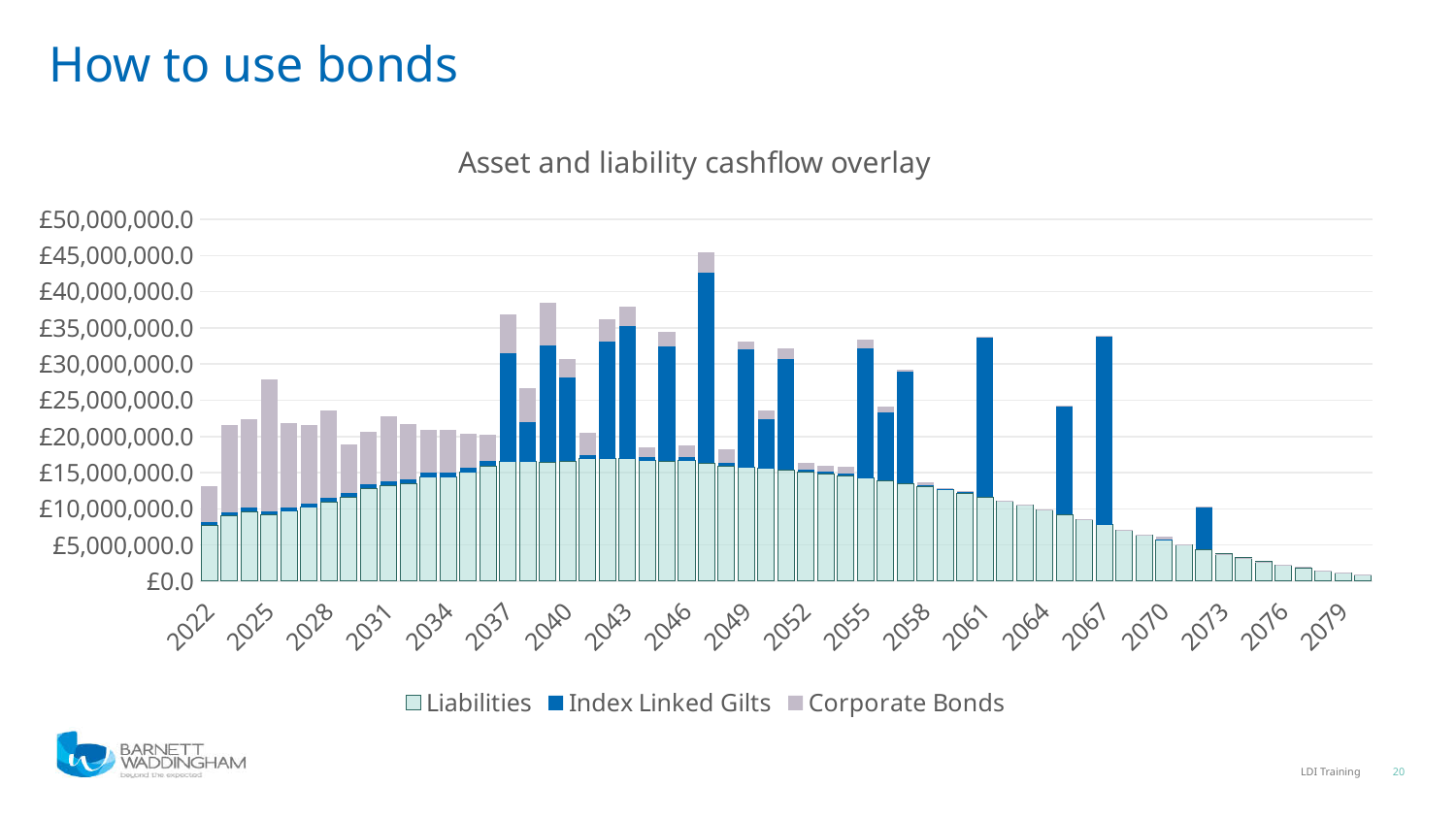
Which year has the larger total stacked value, 2022 or 2025? 2025 Is the total stacked value for 2079 greater or less than £5,000,000.0? less What kind of chart is shown on the slide? Stacked bar chart Is the total stacked value for 2070 greater or less than £10,000,000.0? less How many series does the legend list? 3 Do the total stacked values rise or fall along the x axis from 2061 to 2079? fall What is the title of the chart? Asset and liability cashflow overlay Is the total stacked value for 2043 greater or less than £35,000,000.0? greater Which series is shown in dark blue in the legend? Index Linked Gilts Which year has the larger total stacked value, 2061 or 2079? 2061